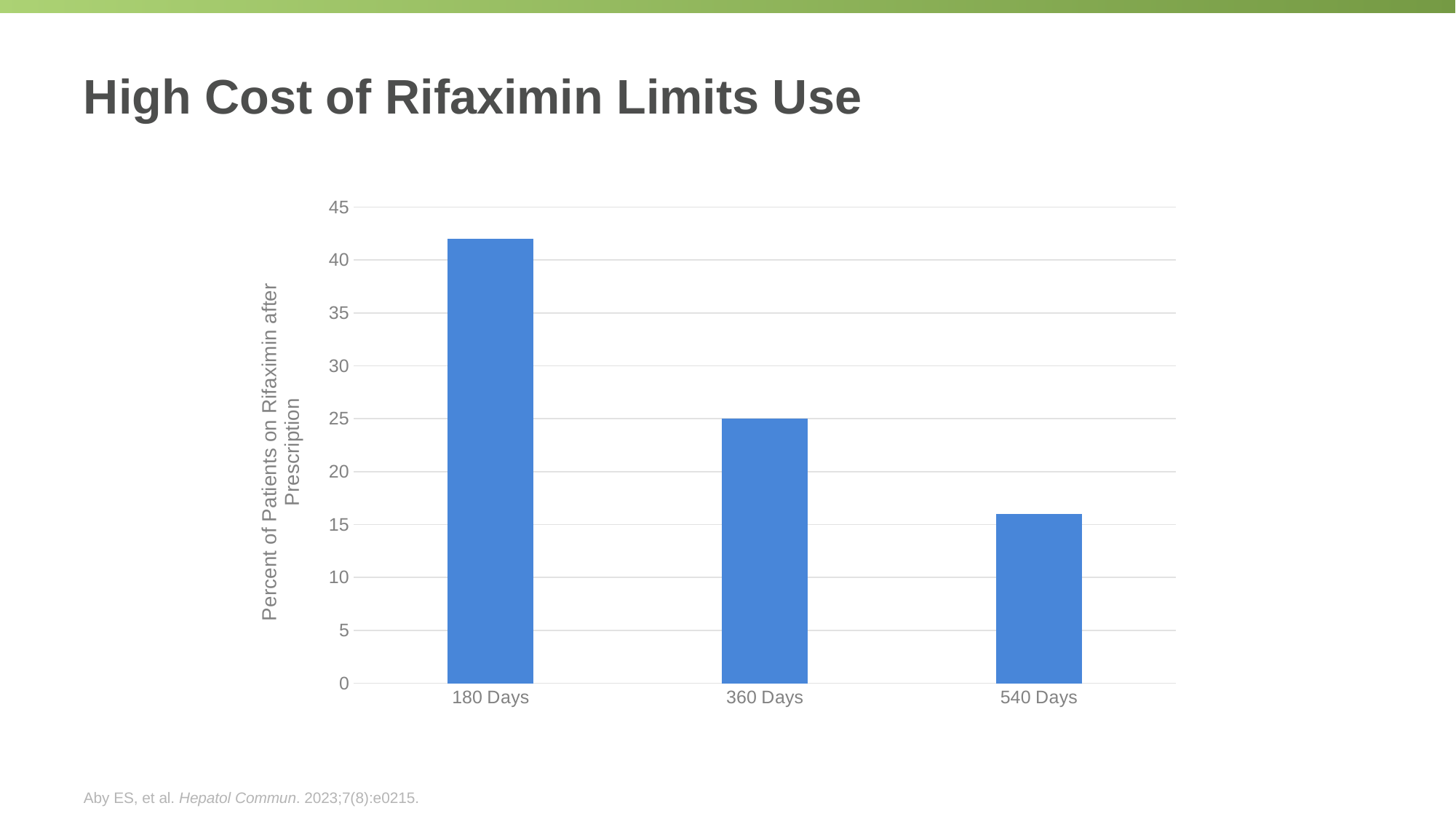
What type of chart is shown on the slide? bar chart Which category has the lowest percent of patients on rifaximin after prescription? 540 Days Is the value for 540 Days greater or less than 20? less Which category has the highest percent of patients on rifaximin after prescription? 180 Days What is the percent of patients on rifaximin after prescription at 360 Days? 25 Do the values rise or fall from 180 Days to 540 Days? fall What is the label of the vertical axis? Percent of Patients on Rifaximin after Prescription Is the value for 180 Days greater or less than 40? greater Which is larger, the value for 360 Days or the value for 540 Days? 360 Days Is the value for 180 Days greater or less than 45? less How many categories are plotted on the x axis? 3